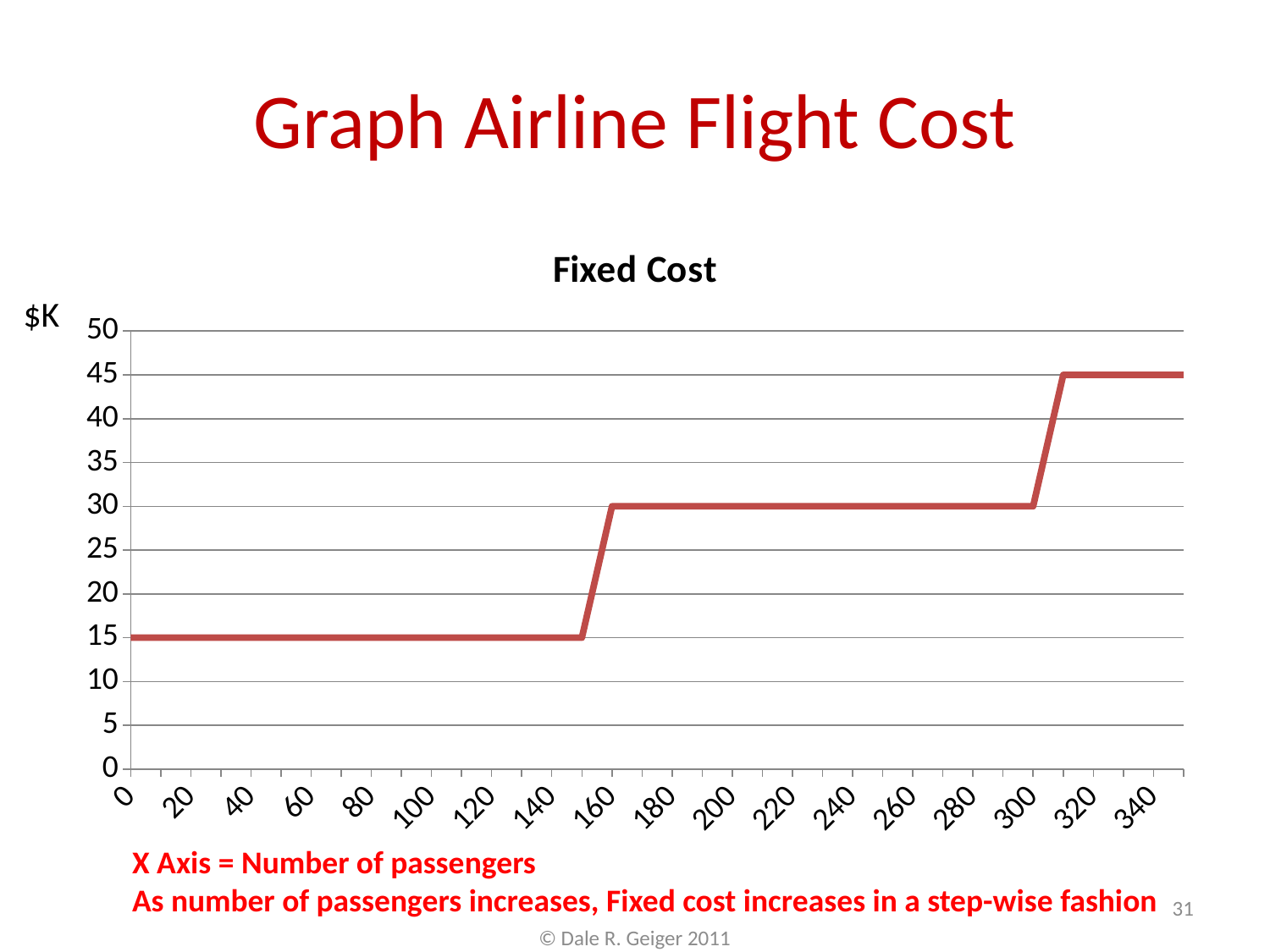
By how much (in $K) does the fixed cost at 200 passengers exceed the fixed cost at 100 passengers? 15 What is the title of the chart? Fixed Cost What unit label is shown next to the vertical axis? $K Does the fixed cost rise or fall as the number of passengers increases along the x axis? rise Which has the larger fixed cost: 240 passengers or 80 passengers? 240 passengers What kind of chart is shown on the slide? line chart What is the fixed cost (in $K) when the number of passengers is 200? 30 What is the fixed cost (in $K) when the number of passengers is 340? 45 What is the fixed cost (in $K) when the number of passengers is 100? 15 What is the lowest fixed cost value (in $K) shown by the line? 15 What is the highest fixed cost value (in $K) reached by the line? 45 Is the fixed cost at 60 passengers greater or less than 20? less